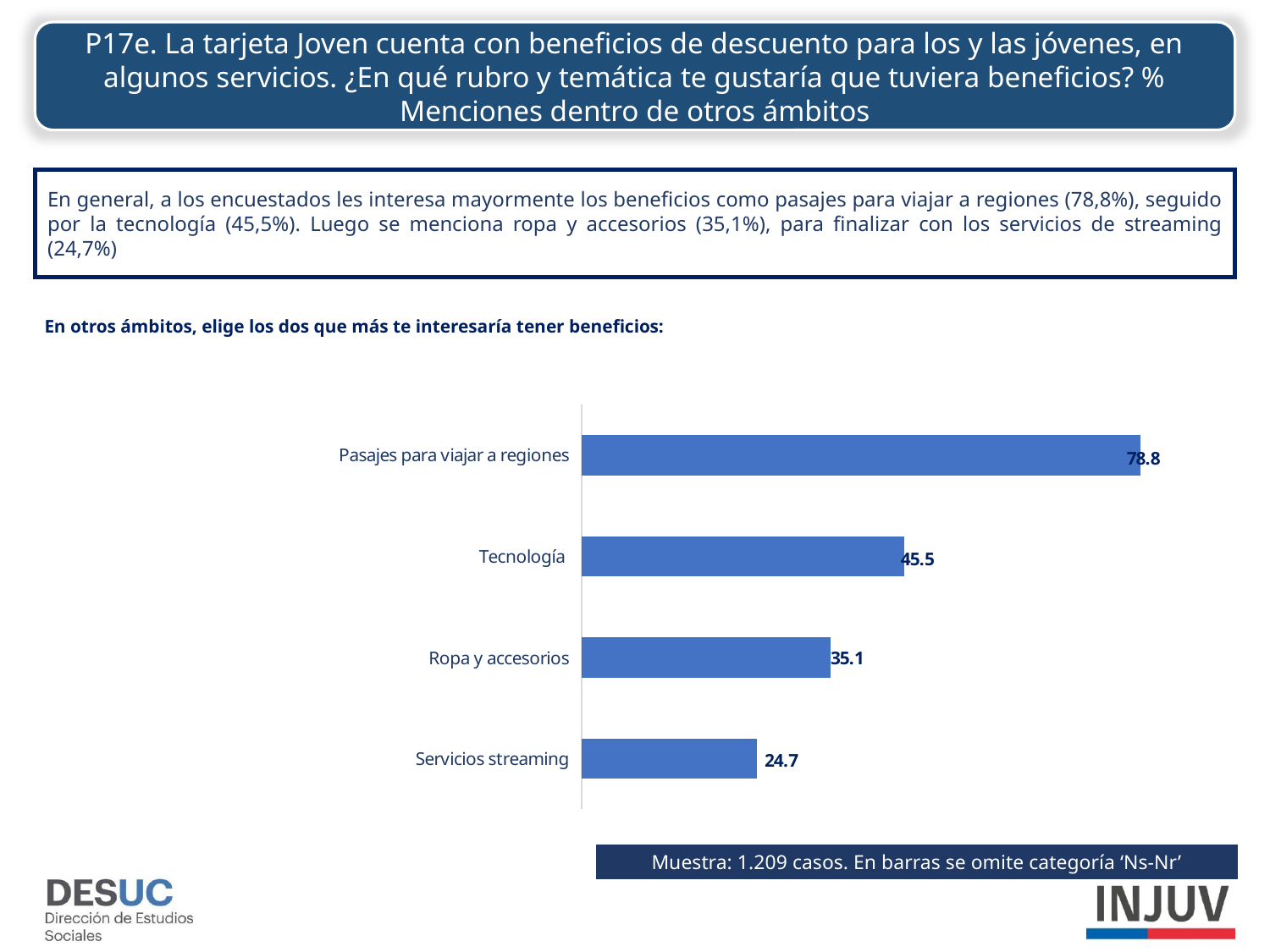
What is the value for Servicios streaming? 24.7 What is the difference between the values for Ropa y accesorios and Servicios streaming? 10.4 Which category has the lowest value? Servicios streaming What is the value for Ropa y accesorios? 35.1 How many categories are shown in the chart? 4 What is the value for Pasajes para viajar a regiones? 78.8 What kind of chart is shown on the slide? Bar chart Which is larger, the value for Tecnología or the value for Ropa y accesorios? Tecnología What colour are the bars in the chart? Blue Which category has the highest value? Pasajes para viajar a regiones What is the difference between the values for Pasajes para viajar a regiones and Tecnología? 33.3 What is the value for Tecnología? 45.5